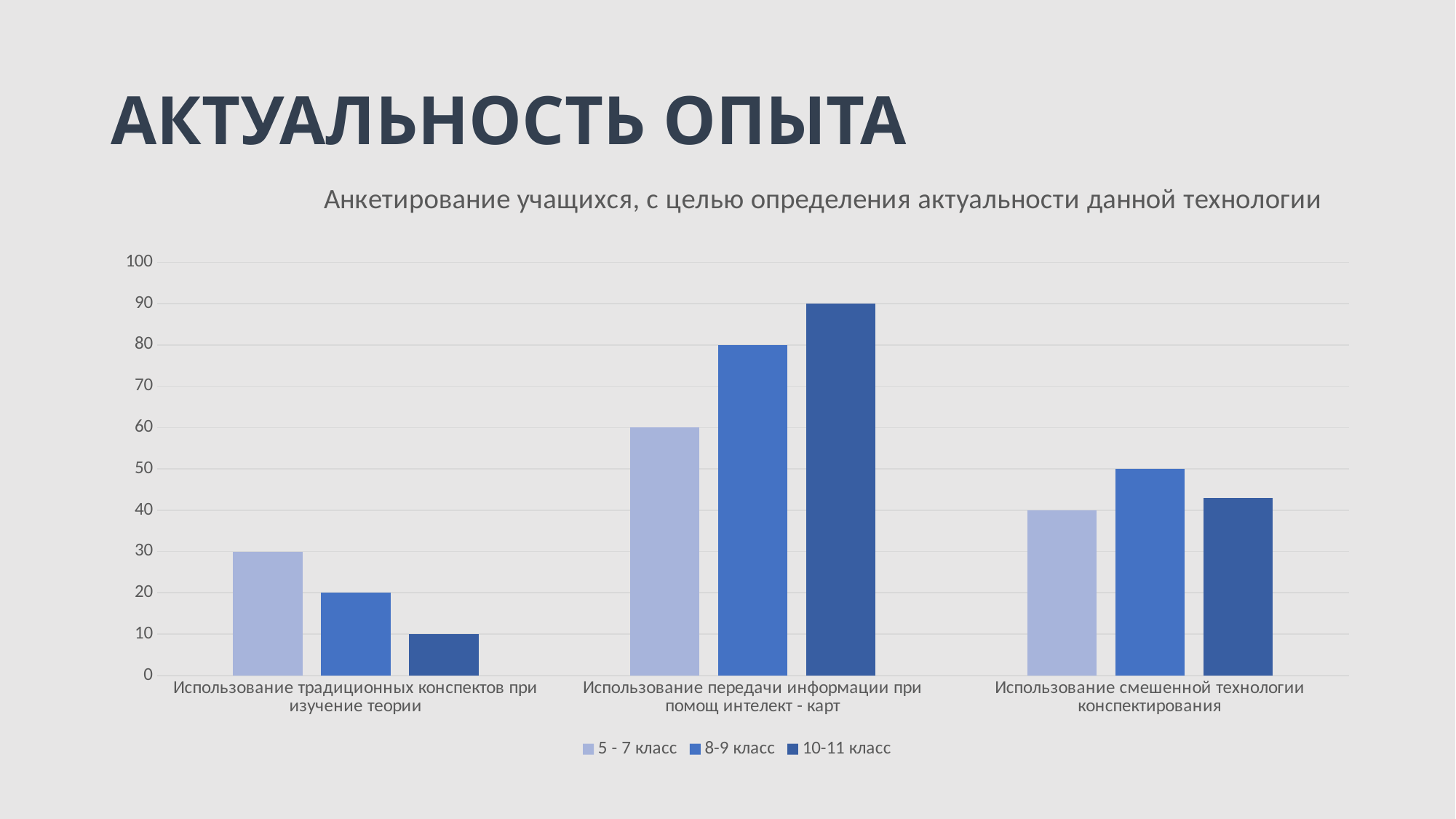
What kind of chart is shown on the slide? bar chart Which is larger for 8-9 класс: the value in 'Использование традиционных конспектов при изучение теории' or in 'Использование смешенной технологии конспектирования'? Использование смешенной технологии конспектирования How many categories are shown on the x axis? 3 What is the value for 10-11 класс in the category 'Использование передачи информации при помощ интелект - карт'? 90 What is the value for 8-9 класс in the category 'Использование смешенной технологии конспектирования'? 50 Which series has the lowest value in the category 'Использование традиционных конспектов при изучение теории'? 10-11 класс Which series has the highest value in the category 'Использование передачи информации при помощ интелект - карт'? 10-11 класс What is the difference between the 10-11 класс and 5 - 7 класс values in the category 'Использование передачи информации при помощ интелект - карт'? 30 Is the value for 10-11 класс in the category 'Использование смешенной технологии конспектирования' greater or less than 50? less What is the title of the chart? Анкетирование учащихся, с целью определения актуальности данной технологии What is the value for 5 - 7 класс in the category 'Использование традиционных конспектов при изучение теории'? 30 How many series does the legend list? 3